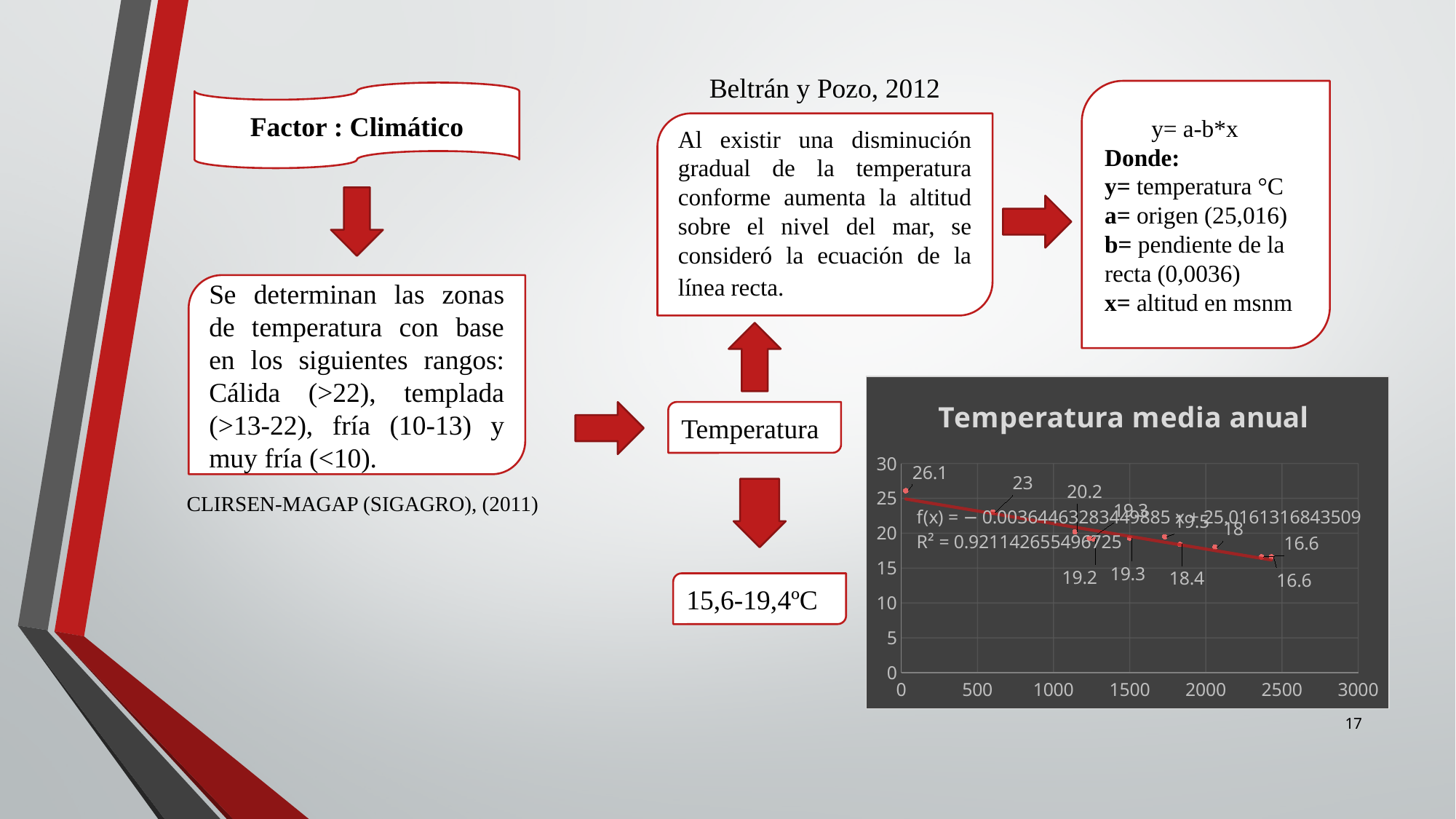
In the "Temperatura media anual" chart, which is larger: the value labelled 26.1 or the value labelled 23? 26.1 In the "Temperatura media anual" chart, is the temperature of the point near 2400 m altitude greater or less than 20? less What kind of chart is shown under the title "Temperatura media anual"? scatter chart What is the maximum value shown on the x axis of the "Temperatura media anual" chart? 3000 In the "Temperatura media anual" chart, do the temperature values rise or fall as altitude increases along the x axis? fall What R² value is printed on the "Temperatura media anual" chart? 0.921142655496725 In the "Temperatura media anual" chart, is the temperature of the point at the lowest altitude (near 0 m) greater or less than 25? greater What is the title of the chart on the slide? Temperatura media anual In the "Temperatura media anual" chart, what is the lowest temperature value labelled? 16.6 What is the maximum value shown on the y axis of the "Temperatura media anual" chart? 30 In the "Temperatura media anual" chart, what is the difference between the highest labelled value (26.1) and the lowest labelled value (16.6)? 9.5 In the "Temperatura media anual" chart, what is the highest temperature value labelled? 26.1